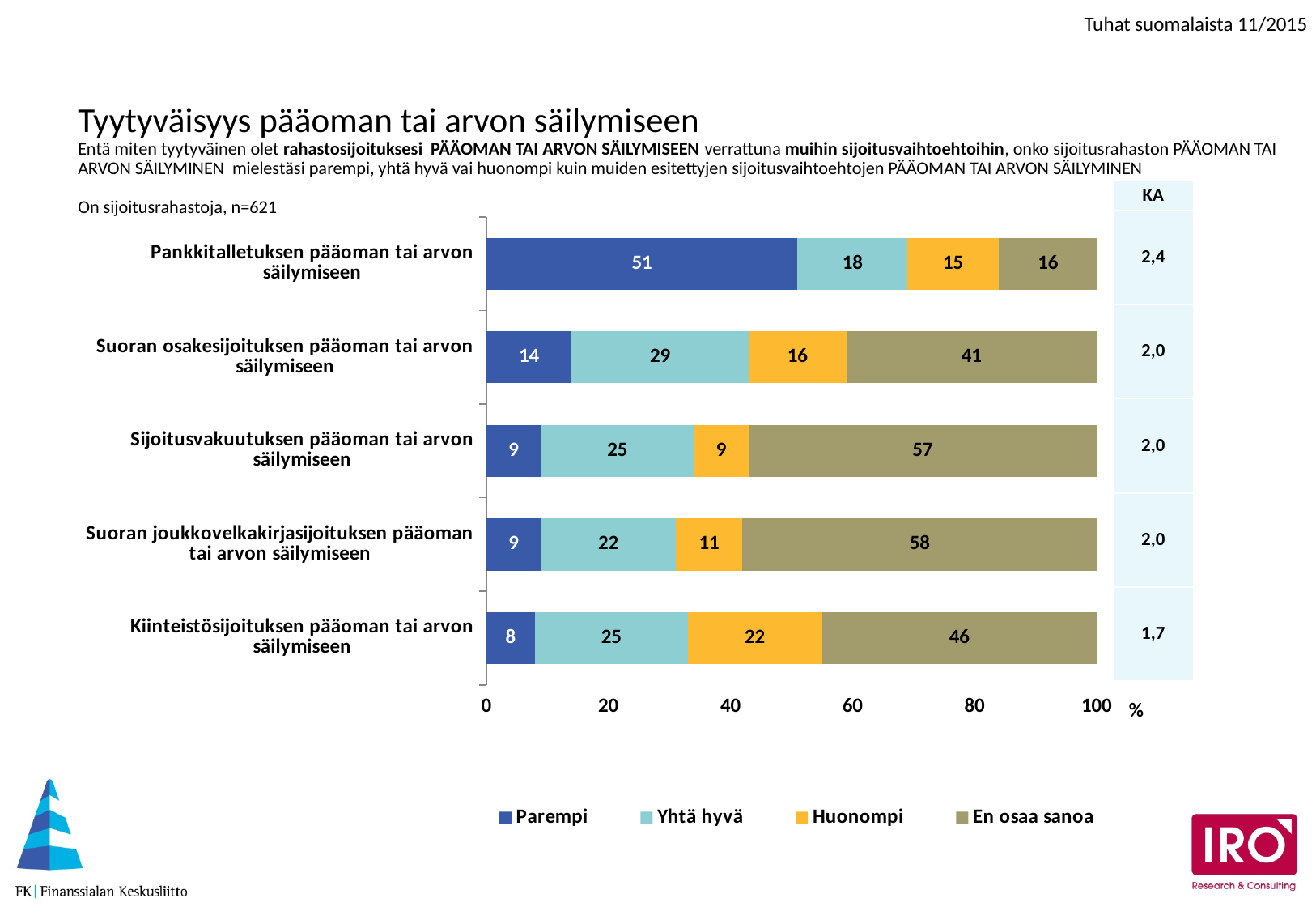
What is the KA value shown for "Kiinteistösijoituksen pääoman tai arvon säilymiseen"? 1,7 What is the value for "Parempi" for "Pankkitalletuksen pääoman tai arvon säilymiseen"? 51 What is the value for "Huonompi" for "Kiinteistösijoituksen pääoman tai arvon säilymiseen"? 22 Which is larger: the "Yhtä hyvä" value for "Suoran osakesijoituksen pääoman tai arvon säilymiseen" or for "Suoran joukkovelkakirjasijoituksen pääoman tai arvon säilymiseen"? Suoran osakesijoituksen pääoman tai arvon säilymiseen What kind of chart is shown on the slide? Stacked bar chart What is the sample size (n) stated on the slide? 621 How many categories are shown on the chart? 5 How many series does the legend list? 4 What is the difference between the "En osaa sanoa" values for "Sijoitusvakuutuksen pääoman tai arvon säilymiseen" and "Suoran osakesijoituksen pääoman tai arvon säilymiseen"? 16 Which category has the highest value for "Parempi"? Pankkitalletuksen pääoman tai arvon säilymiseen Which category has the lowest value for "En osaa sanoa"? Pankkitalletuksen pääoman tai arvon säilymiseen What is the value for "En osaa sanoa" for "Suoran joukkovelkakirjasijoituksen pääoman tai arvon säilymiseen"? 58